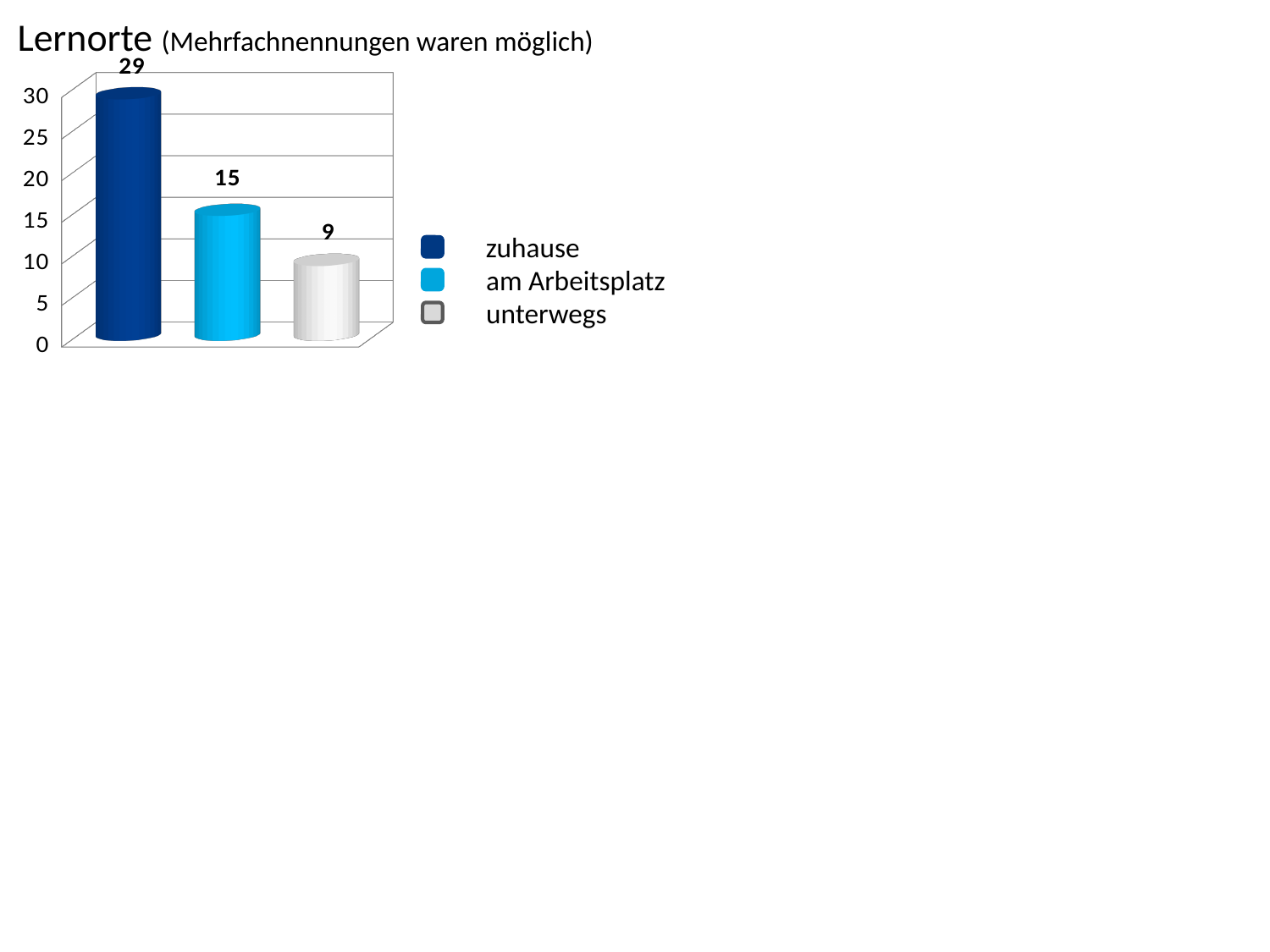
Which category has the highest value? zuhause How many categories are shown in the chart? 3 Which is larger, the value for am Arbeitsplatz or the value for unterwegs? am Arbeitsplatz What is the value for unterwegs? 9 Which category has the lowest value? unterwegs What is the title of the chart? Lernorte (Mehrfachnennungen waren möglich) What is the difference between the values for zuhause and am Arbeitsplatz? 14 What is the value for zuhause? 29 What kind of chart is shown on the slide? bar chart What is the difference between the values for am Arbeitsplatz and unterwegs? 6 What is the value for am Arbeitsplatz? 15 How many entries does the legend list? 3